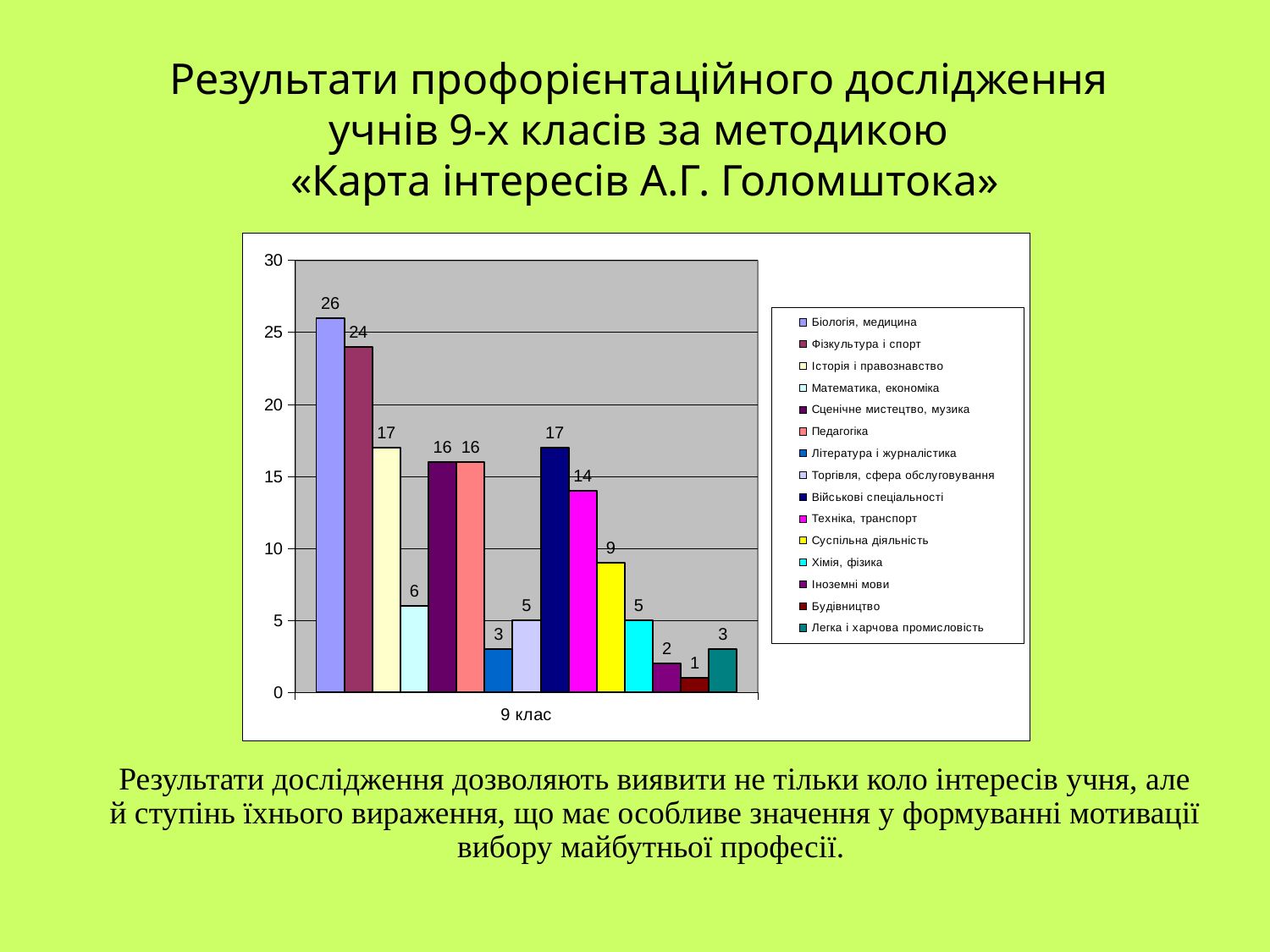
Which series has the highest value? Біологія, медицина How many series does the legend list? 15 What is the value for Біологія, медицина? 26 What is the value for Суспільна діяльність? 9 What is the value for Фізкультура і спорт? 24 What is the value for Техніка, транспорт? 14 Which series has the lowest value? Будівництво What is the category label shown on the x axis? 9 клас What is the difference between the values for Біологія, медицина and Фізкультура і спорт? 2 What kind of chart is shown on the slide? bar chart Is the value for Військові спеціальності greater or less than 15? greater Which is larger, the value for Математика, економіка or the value for Суспільна діяльність? Суспільна діяльність